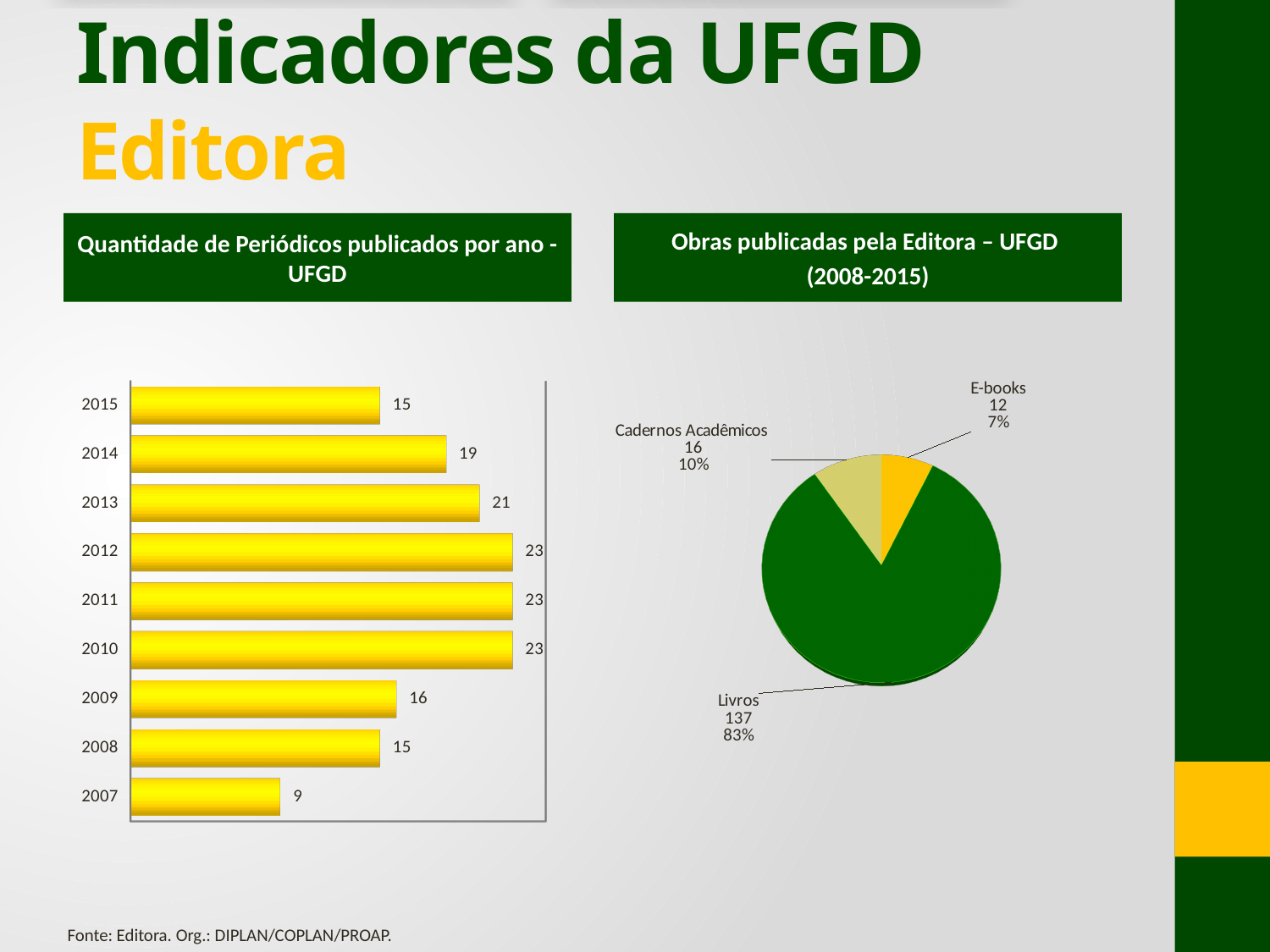
In the 'Quantidade de Periódicos publicados por ano - UFGD' chart, how many years have a value of 23? 3 In the 'Quantidade de Periódicos publicados por ano - UFGD' chart, which is larger, the value for 2009 or the value for 2013? 2013 In the 'Obras publicadas pela Editora – UFGD (2008-2015)' chart, what share of the pie is Cadernos Acadêmicos? 10% In the 'Quantidade de Periódicos publicados por ano - UFGD' chart, how many years are shown? 9 In the 'Quantidade de Periódicos publicados por ano - UFGD' chart, what is the value for 2007? 9 What kind of chart is the 'Quantidade de Periódicos publicados por ano - UFGD' chart? bar chart What kind of chart is the 'Obras publicadas pela Editora – UFGD (2008-2015)' chart? pie chart In the 'Quantidade de Periódicos publicados por ano - UFGD' chart, what is the value for 2013? 21 In the 'Obras publicadas pela Editora – UFGD (2008-2015)' chart, which category has the smallest slice? E-books In the 'Obras publicadas pela Editora – UFGD (2008-2015)' chart, what is the value for Livros? 137 In the 'Quantidade de Periódicos publicados por ano - UFGD' chart, what is the difference between the values for 2014 and 2015? 4 In the 'Quantidade de Periódicos publicados por ano - UFGD' chart, which year has the lowest value? 2007